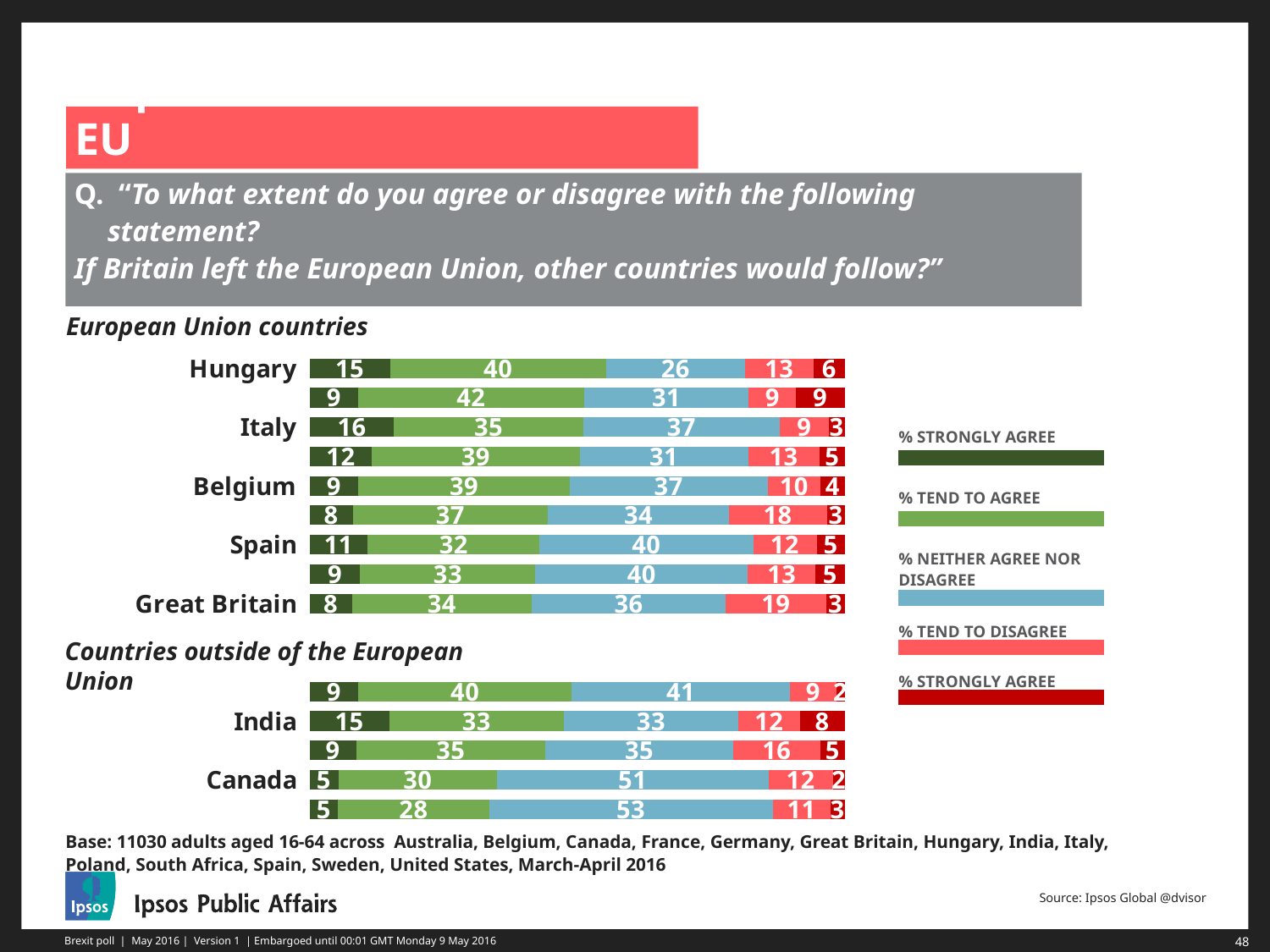
What is the '% NEITHER AGREE NOR DISAGREE' value for Canada? 51 What is the difference between the '% STRONGLY AGREE' values for Hungary and Canada? 10 Among the labelled countries, which has the highest '% NEITHER AGREE NOR DISAGREE' value? Canada What percentage of respondents in Hungary strongly agree that other countries would follow if Britain left the EU? 15 What kind of chart is shown on the slide? Stacked bar chart Among the labelled countries, which has the lowest '% STRONGLY AGREE' value? Canada Which country is listed first under 'Countries outside of the European Union'? India What is the '% TEND TO DISAGREE' value for Great Britain? 19 What is the total of the stacked bar for Canada? 100 Which has a higher '% TEND TO AGREE' value, Hungary or Italy? Hungary How many series does the legend list? 5 What is the '% TEND TO AGREE' value for Belgium? 39